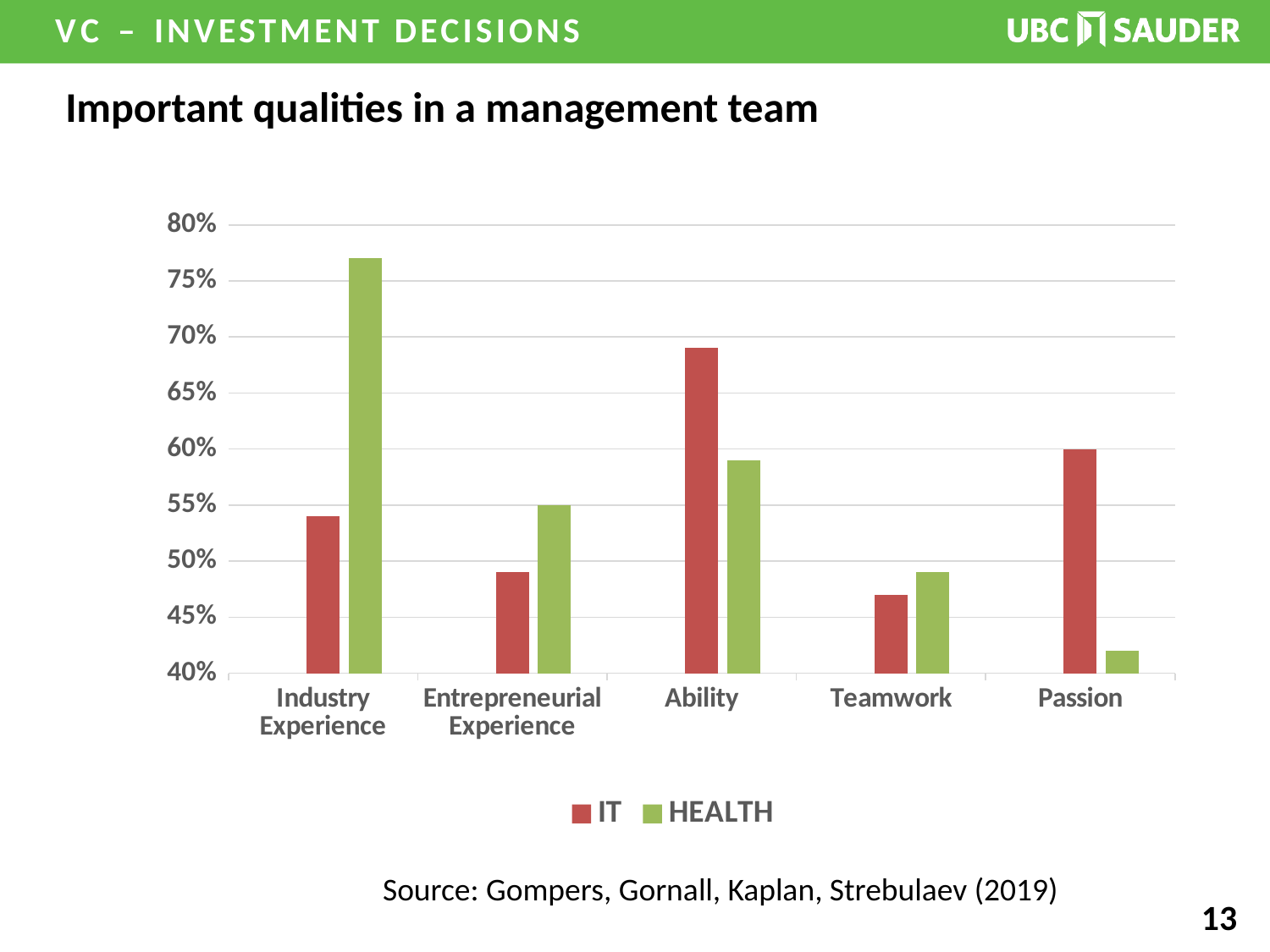
For which category is the HEALTH value lowest? Passion Is the HEALTH value for Industry Experience greater or less than 75%? greater How many categories are shown on the x axis of the chart? 5 For which category is the HEALTH value highest? Industry Experience For which category is the IT value highest? Ability Which series is shown in green in the chart? HEALTH For Ability, which series has the larger value, IT or HEALTH? IT What is the title of the chart? Important qualities in a management team For Industry Experience, which series has the larger value, IT or HEALTH? HEALTH What kind of chart is shown on the slide? bar chart Is the HEALTH value for Passion greater or less than 45%? less How many series does the legend list? 2